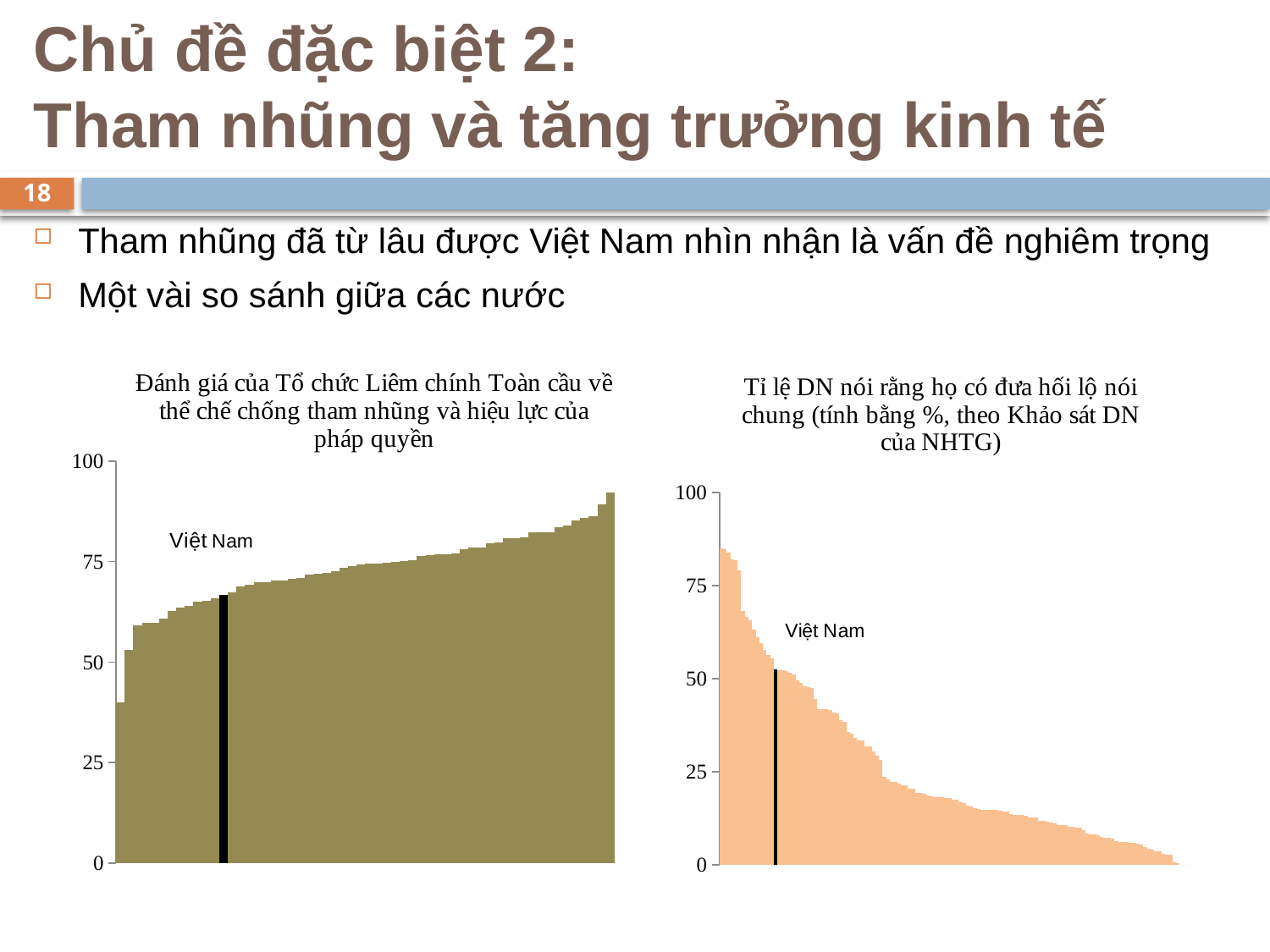
What kind of chart is the right chart, titled "Tỉ lệ DN nói rằng họ có đưa hối lộ nói chung"? bar chart In the right chart (Tỉ lệ DN nói rằng họ có đưa hối lộ), do the bar values rise or fall from left to right? fall In the right chart (Tỉ lệ DN nói rằng họ có đưa hối lộ), is the value for Việt Nam greater or less than 75? less In the right chart (Tỉ lệ DN nói rằng họ có đưa hối lộ), is the value for Việt Nam greater or less than 25? greater In the left chart (Đánh giá của Tổ chức Liêm chính Toàn cầu), is the value for Việt Nam greater or less than 75? less What kind of chart is the left chart, titled "Đánh giá của Tổ chức Liêm chính Toàn cầu về thể chế chống tham nhũng và hiệu lực của pháp quyền"? bar chart In the left chart (Đánh giá của Tổ chức Liêm chính Toàn cầu), do the bar values rise or fall from left to right? rise Which country is labelled and highlighted with a black bar in both charts? Việt Nam